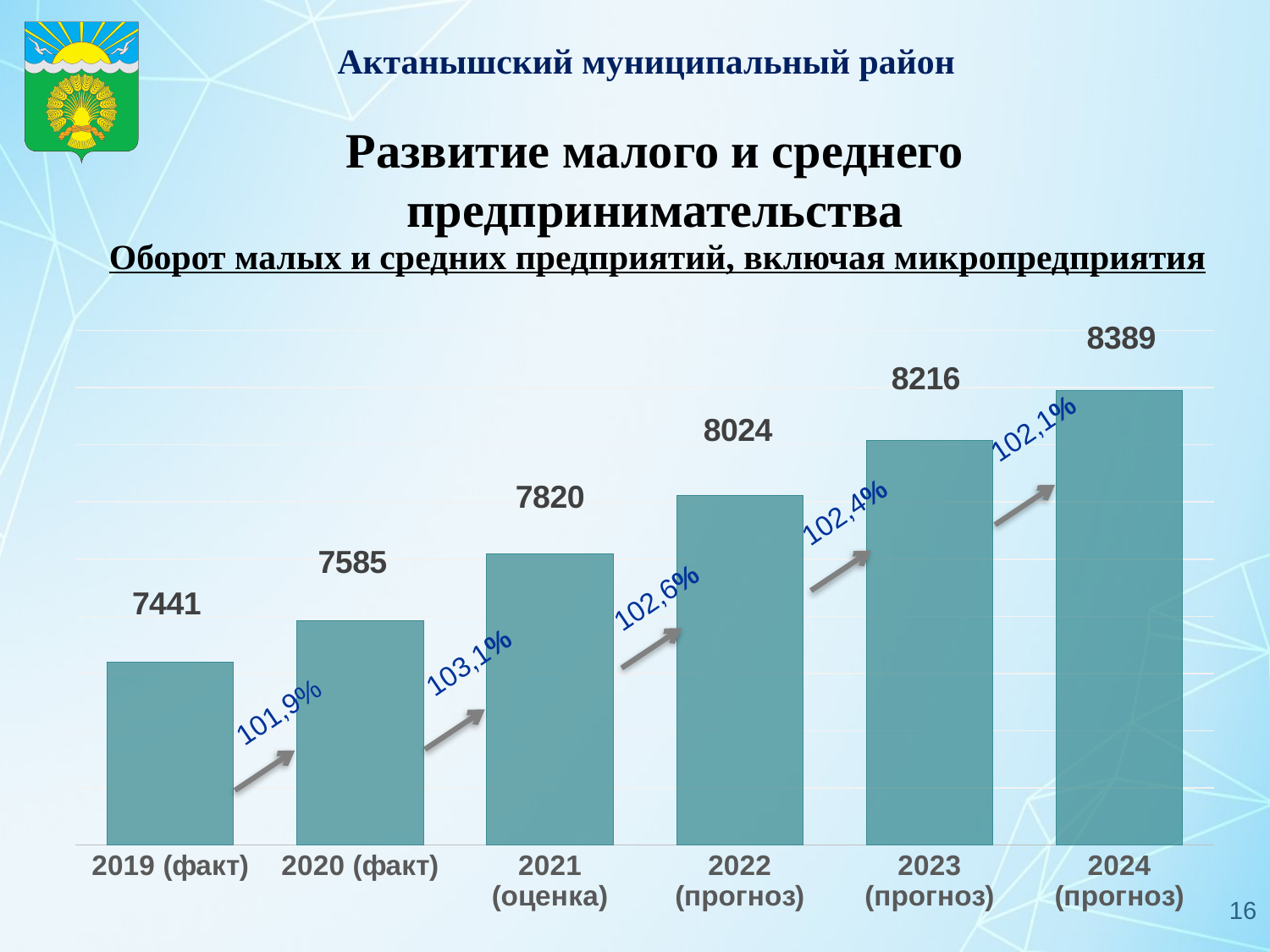
What is the difference between the values for 2021 (оценка) and 2020 (факт)? 235 Which category has the lowest value? 2019 (факт) Do the values rise or fall from 2019 to 2024? rise How many categories are shown on the x axis? 6 What is the difference between the values for 2024 (прогноз) and 2019 (факт)? 948 What is the value for 2022 (прогноз)? 8024 What is the value for 2024 (прогноз)? 8389 Which category has the highest value? 2024 (прогноз) Which is larger, the value for 2023 (прогноз) or the value for 2021 (оценка)? 2023 (прогноз) What is the value for 2019 (факт)? 7441 What growth percentage is shown between 2020 (факт) and 2021 (оценка)? 103,1% What kind of chart is this? bar chart